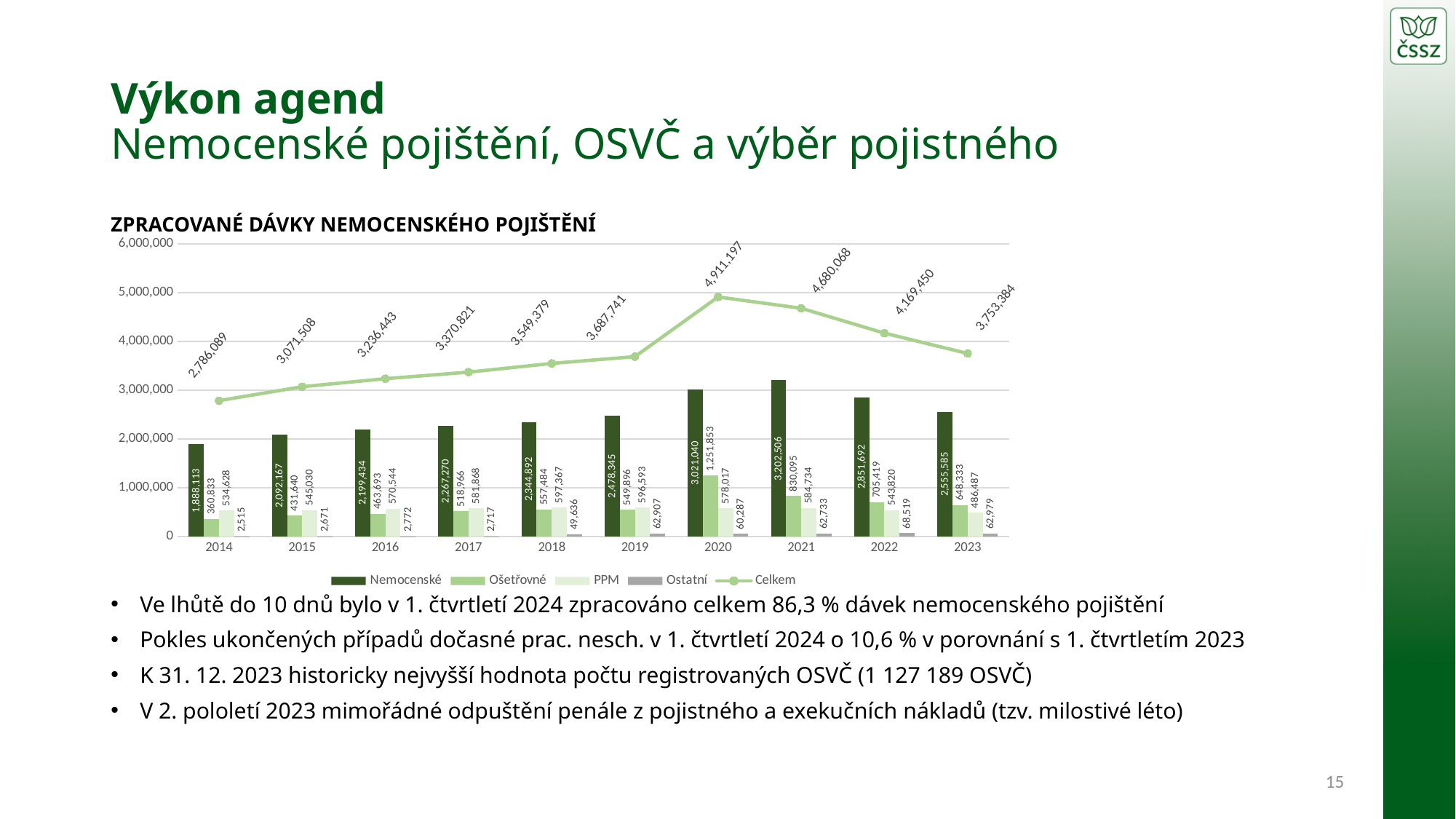
How many series does the legend list? 5 What is the difference between the Celkem values for 2020 and 2019? 1,223,456 What is the Nemocenské value for 2023? 2,555,585 Which is larger, the Nemocenské value for 2021 or for 2022? 2021 What is the Ošetřovné value for 2020? 1,251,853 In which year is the Celkem line at its highest? 2020 In which year is the Ostatní value lowest? 2014 Does the Celkem line rise or fall from 2020 to 2023? Fall How many years are shown on the x axis? 10 What kind of chart is this? Combined bar and line chart What is the value of Celkem for 2020? 4,911,197 What is the PPM value for 2017? 581,868